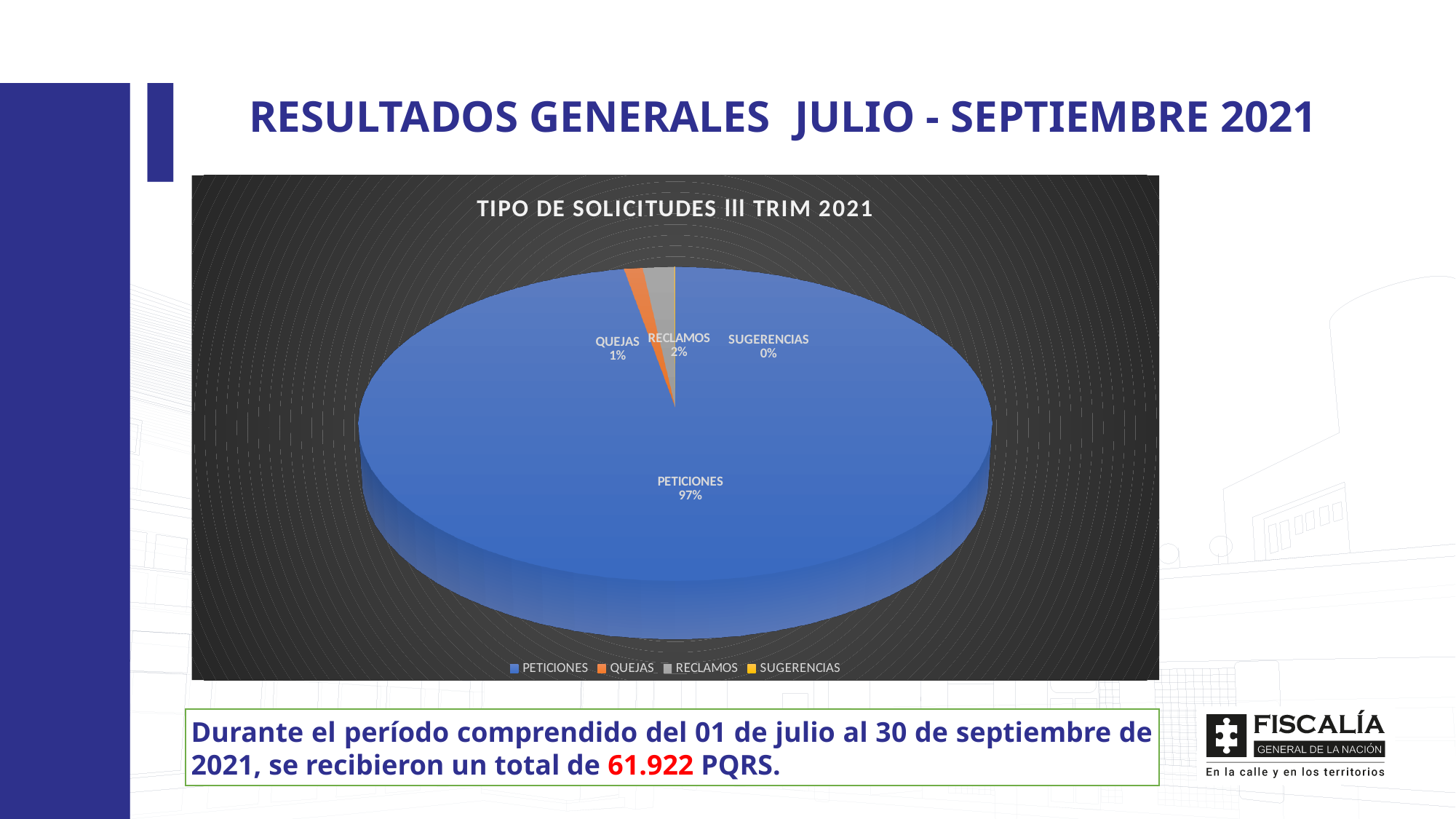
What share of the pie does SUGERENCIAS represent? 0% Which is larger, the share for RECLAMOS or the share for QUEJAS? RECLAMOS What share of the pie does PETICIONES represent? 97% What is the title of the chart? TIPO DE SOLICITUDES III TRIM 2021 Which category has the largest slice of the pie? PETICIONES What kind of chart is shown on the slide? Pie chart What colour is the PETICIONES slice in the pie chart? Blue What is the difference in percentage points between the PETICIONES share and the RECLAMOS share? 95% Which category has the smallest slice of the pie? SUGERENCIAS What share of the pie does RECLAMOS represent? 2% How many categories are shown in the pie chart? 4